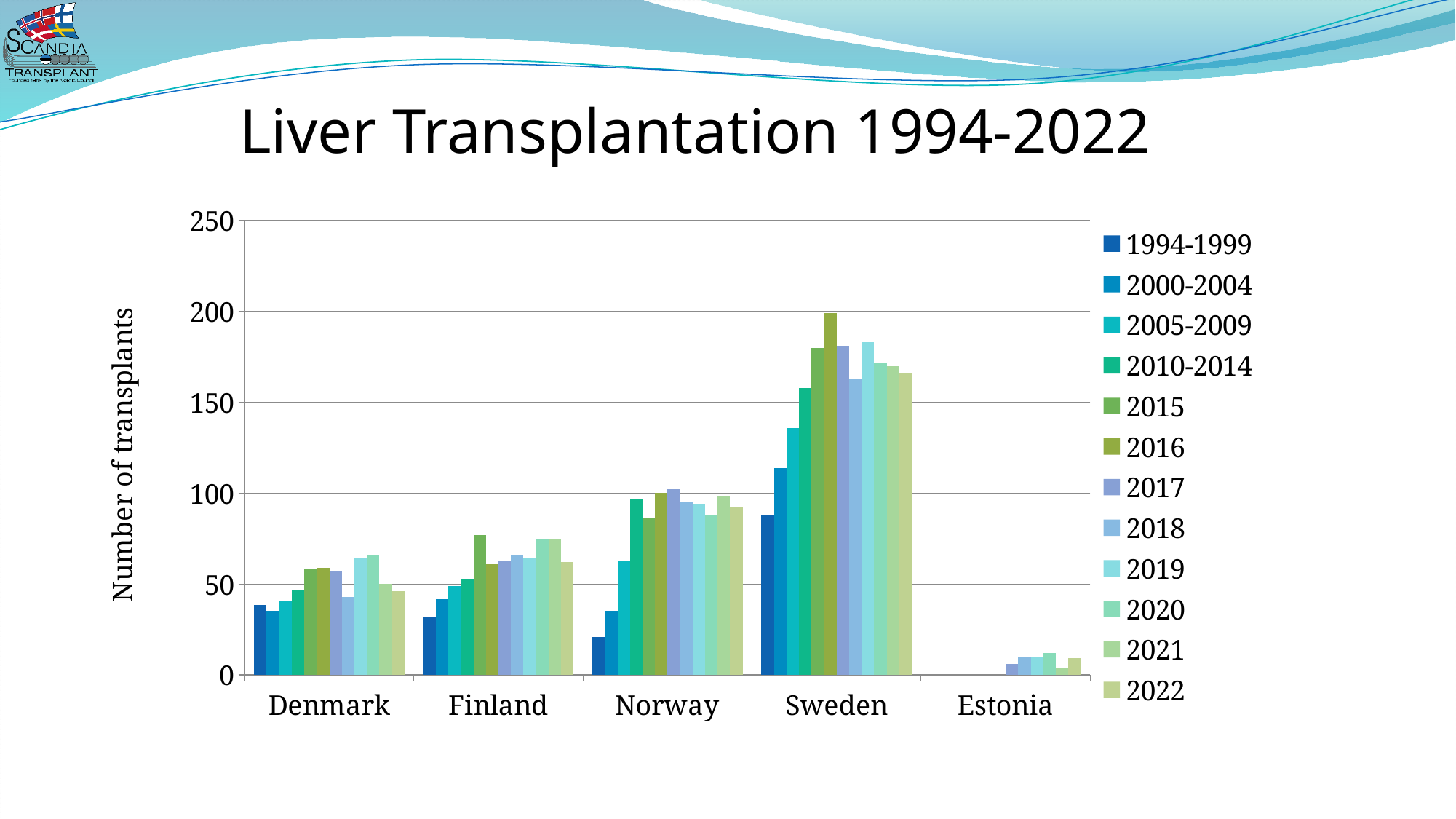
Which country has the lowest number of liver transplants in the chart? Estonia Is the value for Sweden in 2019 greater or less than 150? greater How many series does the legend list? 12 For Sweden, which period has the highest bar? 2016 Is the value for Sweden in 1994-1999 greater or less than 100? less What kind of chart is shown on the slide? bar chart Is the value for Denmark in 2015 greater or less than 50? greater How many countries are shown on the x axis of the chart? 5 Which country has the highest number of liver transplants in the chart? Sweden What is the label of the y axis? Number of transplants Which is larger, the value for Sweden in 2022 or the value for Norway in 2022? Sweden in 2022